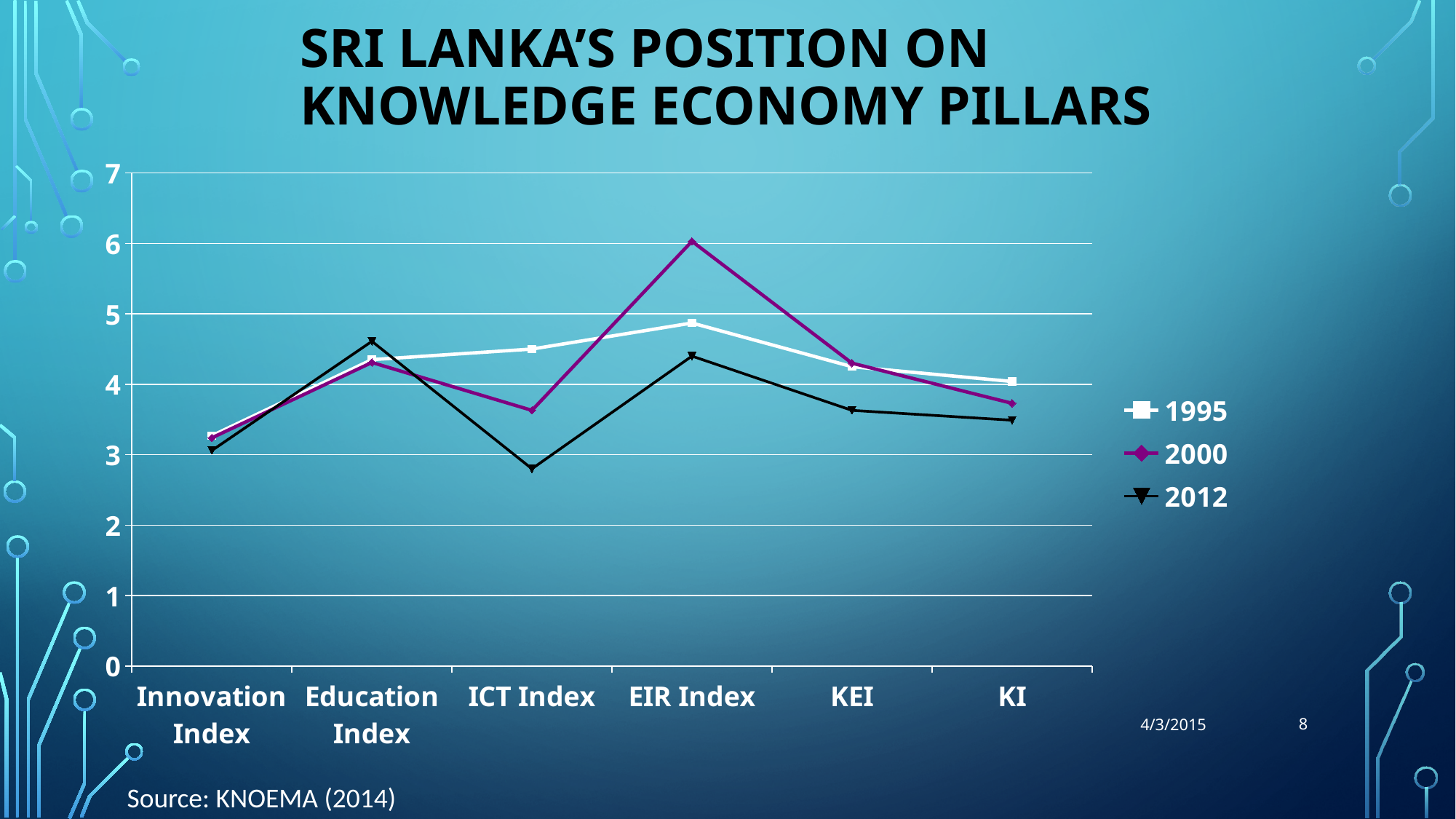
For ICT Index, which series has the larger value, 1995 or 2012? 1995 For the 2000 series, which category has the highest value? EIR Index What kind of chart is shown on the slide? line chart Is the 2012 value for ICT Index greater or less than 3? less For EIR Index, which series has the larger value, 1995 or 2000? 2000 Is the 2000 value for EIR Index greater or less than 5? greater Does the 2012 series rise or fall from EIR Index to KI? fall What source is cited below the chart? KNOEMA (2014) For the 2012 series, which category has the highest value? Education Index How many series does the legend list? 3 For the 2012 series, which category has the lowest value? ICT Index How many categories are plotted along the x axis? 6